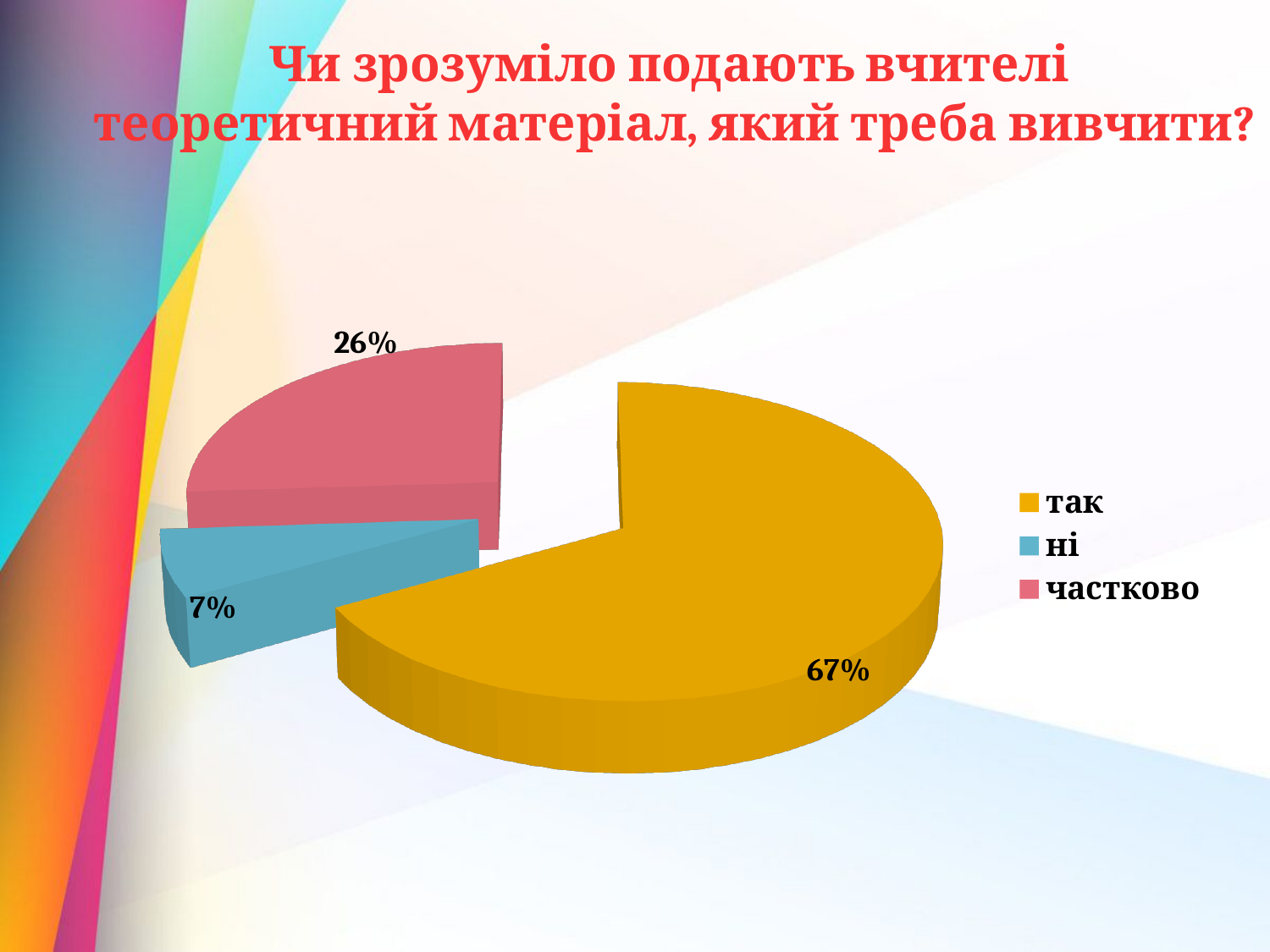
What colour is the slice for "так"? yellow What kind of chart is shown on the slide? pie chart What share of the pie does "ні" have? 7% Which category has the smallest slice of the pie? ні Which category has the largest slice of the pie? так What is the title of the slide? Чи зрозуміло подають вчителі теоретичний матеріал, який треба вивчити? What share of the pie does "так" have? 67% What share of the pie does "частково" have? 26% Which is larger, the share for "ні" or the share for "частково"? частково What is the difference in percentage points between "частково" and "ні"? 19 What is the difference in percentage points between "так" and "частково"? 41 How many slices does the pie chart have? 3